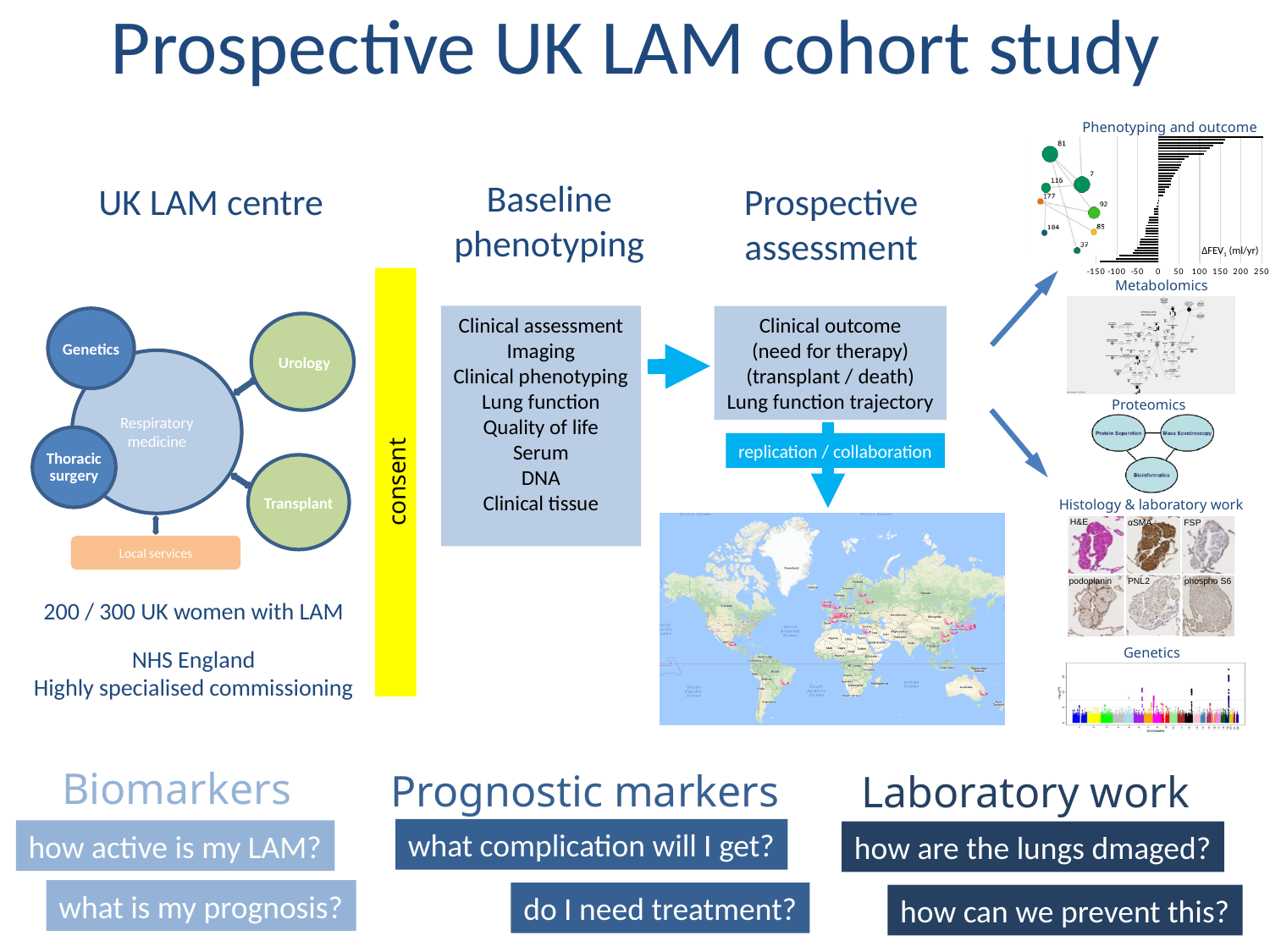
What is the highest tick value shown on the x axis of the 'Phenotyping and outcome' bar chart? 250 What is the title of the chart at the bottom of the right-hand column of the slide, showing a multi-coloured plot? Genetics What is the lowest tick value shown on the x axis of the 'Phenotyping and outcome' bar chart? -150 In the network diagram of numbered circles at the top right of the slide, which circle has the smallest number label? 7 In the 'Phenotyping and outcome' bar chart, do the bar values decrease or increase going from the top bar to the bottom bar? decrease In the network diagram of numbered circles at the top right of the slide, which circle has the largest number label? 184 What kind of chart is the 'Phenotyping and outcome' chart in the top right of the slide? bar chart In the network diagram of numbered circles at the top right of the slide, how many circles have a number label? 8 In the network diagram of numbered circles at the top right of the slide, which number label is larger, 116 or 92? 116 What is the x-axis label of the 'Phenotyping and outcome' bar chart? ΔFEV1 (ml/yr)